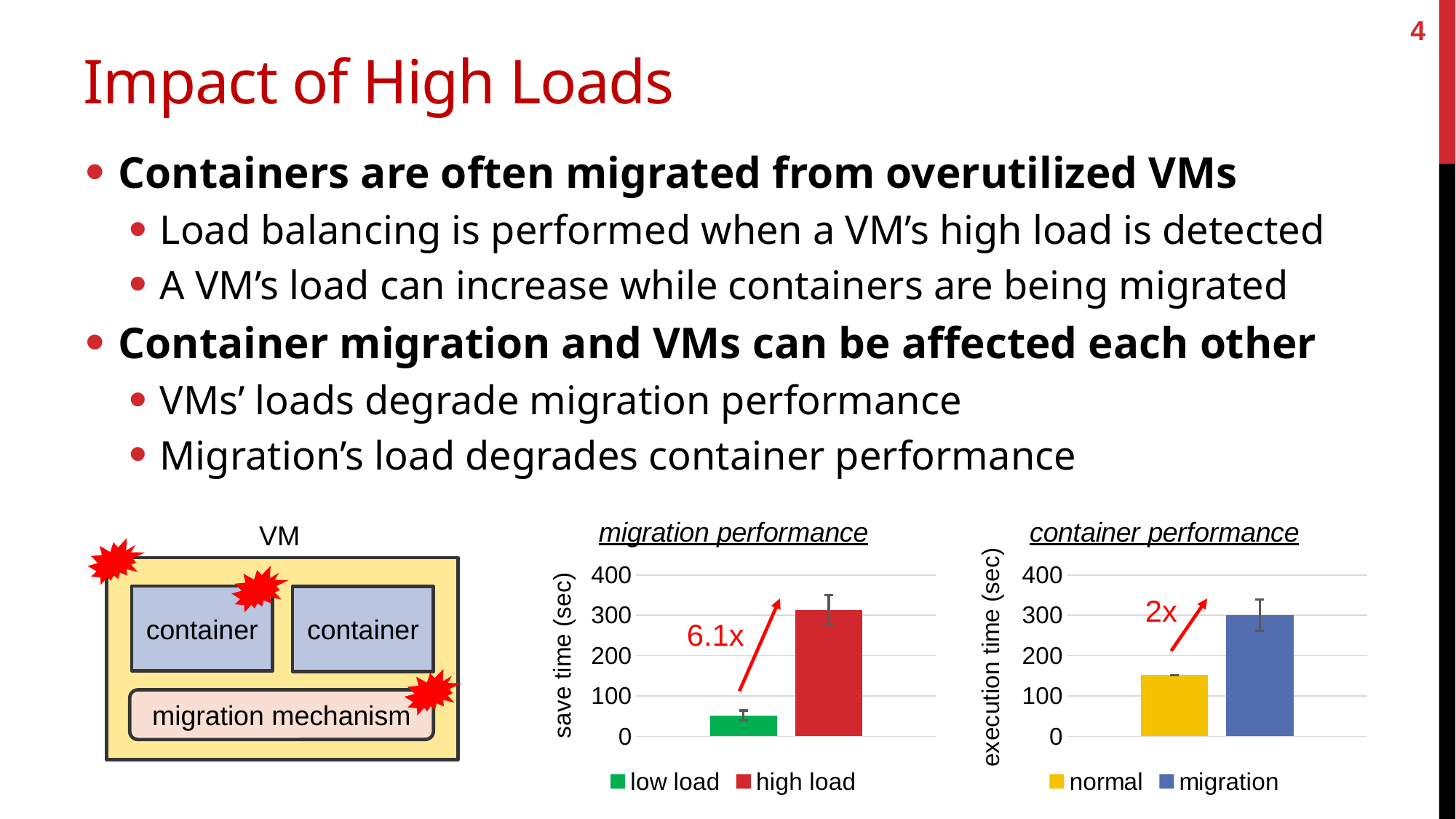
In the 'migration performance' chart, which series has the higher save time, low load or high load? high load In the 'migration performance' chart, what kind of chart is shown? bar chart In the 'container performance' chart, is the execution time for migration greater or less than 200? greater In the 'container performance' chart, which series has the lower execution time? normal In the 'container performance' chart, what is the highest value shown on the y axis? 400 In the 'container performance' chart, how many series does the legend list? 2 In the 'migration performance' chart, how many series does the legend list? 2 In the 'container performance' chart, is the execution time for normal greater or less than 200? less In the 'migration performance' chart, what factor of increase is annotated between the low load and high load bars? 6.1x In the 'migration performance' chart, what is the label of the y axis? save time (sec) In the 'migration performance' chart, is the save time for low load greater or less than 100? less